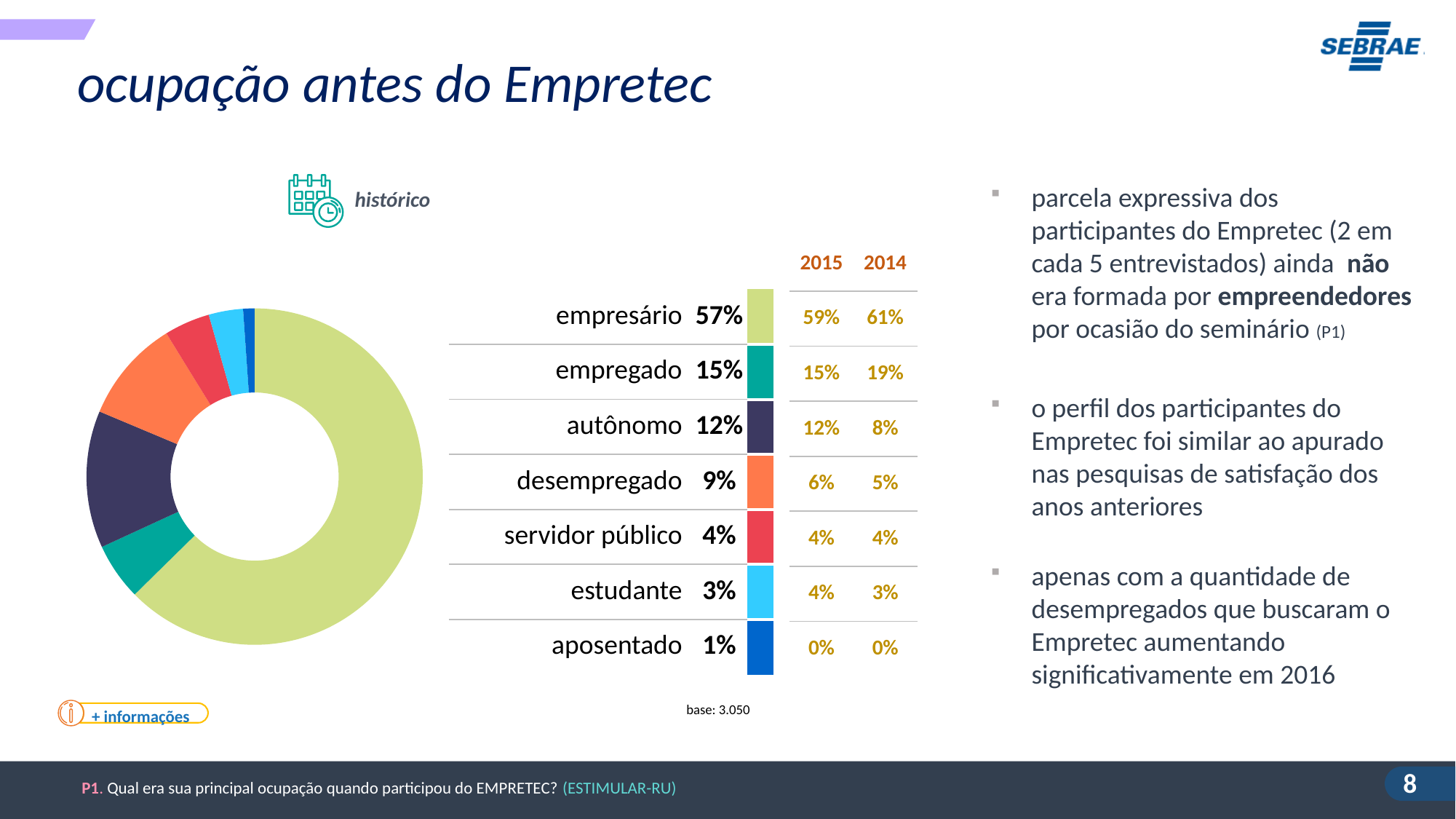
What is the value for autônomo? 12% What is the difference between the shares for empregado and autônomo? 3% What share of participants were empresário before Empretec? 57% How many occupation categories are shown in the chart? 7 What colour is the empresário slice of the donut chart? Light green What kind of chart is shown on the slide? Donut (pie) chart What was the share of empresário in 2014 according to the histórico columns? 61% Which is larger, the share for servidor público or the share for estudante? servidor público What was the share of desempregado in 2015? 6% Which occupation category has the highest share? empresário What is the value for desempregado? 9% Which occupation category has the lowest share? aposentado